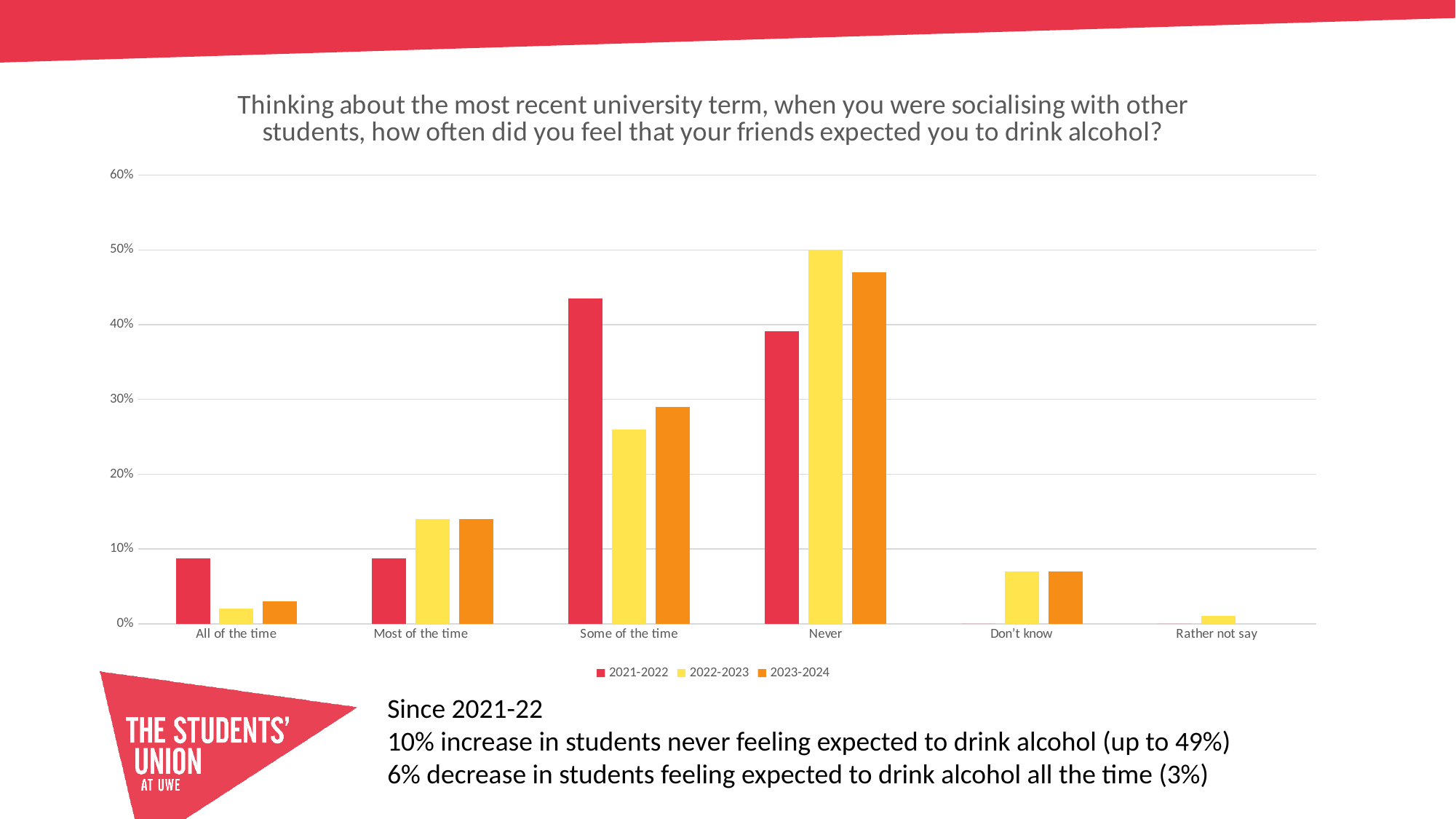
How many response categories are shown on the x axis? 6 For Never, which series has the larger value: 2021-2022 or 2022-2023? 2022-2023 What kind of chart is shown on the slide? bar chart Which category has the highest bar for the 2021-2022 series? Some of the time Which category has the highest bar for the 2022-2023 series? Never Which series is shown in yellow in the legend? 2022-2023 Is the value for All of the time in 2021-2022 greater or less than 10%? less Which category has a bar only for the 2022-2023 series? Rather not say How many series does the legend list? 3 Is the value for Some of the time in 2022-2023 greater or less than 30%? less Is the value for Never in 2023-2024 greater or less than 40%? greater For Some of the time, which series has the larger value: 2021-2022 or 2023-2024? 2021-2022